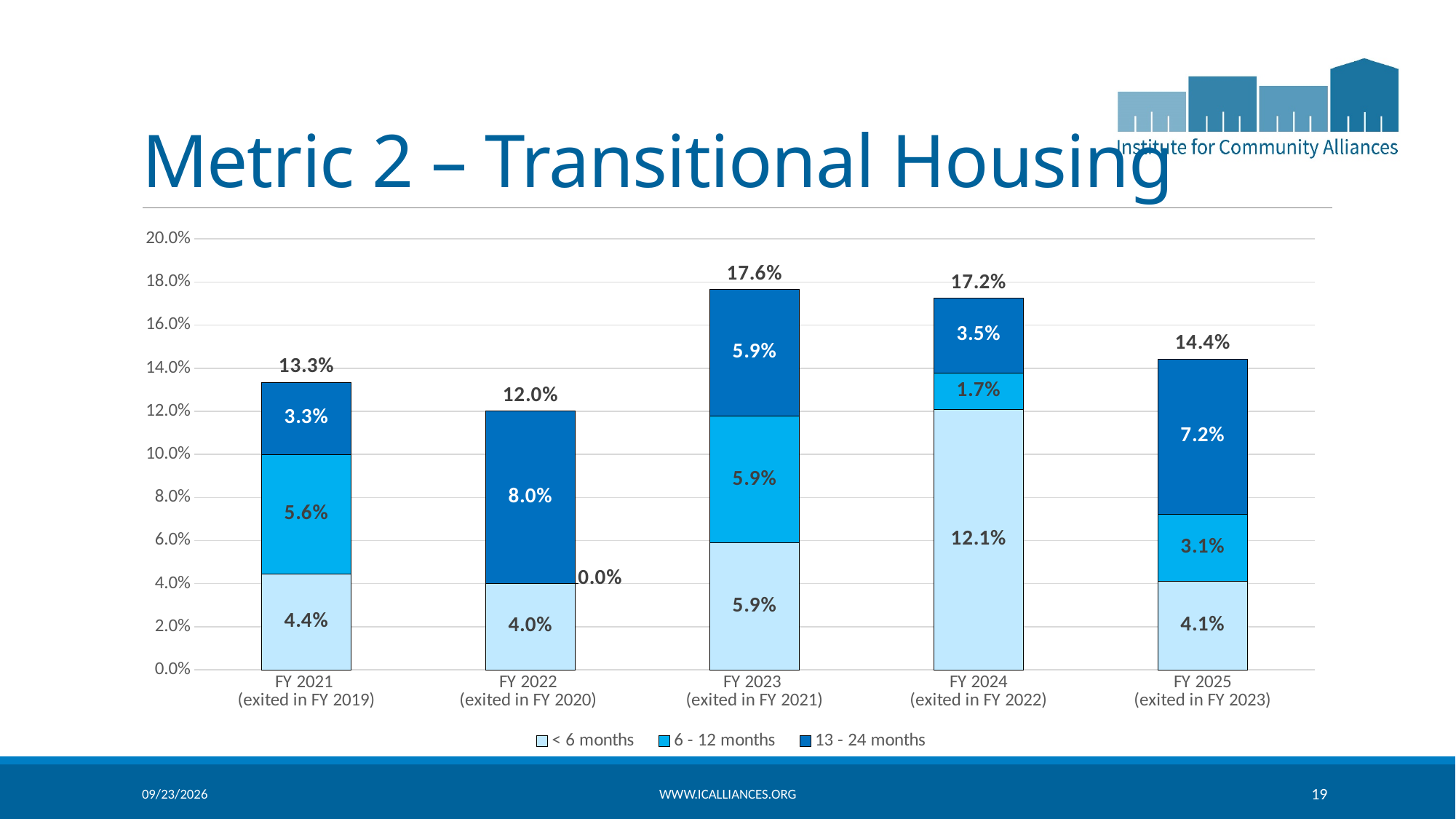
What is the difference between the total for FY 2025 and the total for FY 2021? 1.1% How many fiscal year categories are plotted on the x axis? 5 Which is larger: the '13 - 24 months' value in FY 2025 or the '13 - 24 months' value in FY 2024? FY 2025 Which fiscal year has the highest total? FY 2023 What type of chart is shown on the slide? Stacked bar chart What is the value for '< 6 months' in FY 2024? 12.1% What is the value for '13 - 24 months' in FY 2022? 8.0% What is the title of the slide containing the chart? Metric 2 – Transitional Housing What is the total of the stacked bar for FY 2023? 17.6% What is the value for '6 - 12 months' in FY 2025? 3.1% Which fiscal year has the lowest total? FY 2022 How many series does the legend list? 3